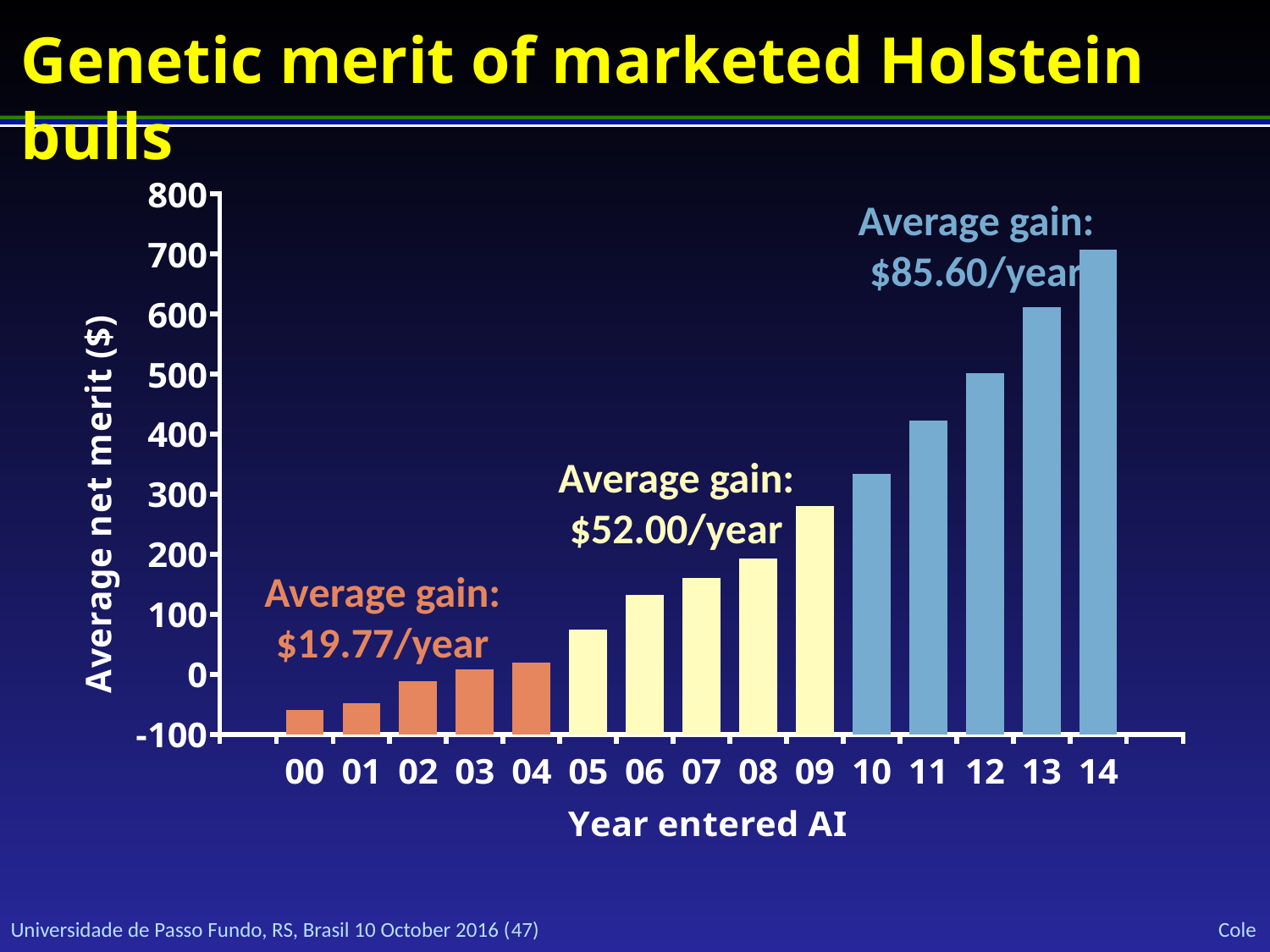
Do the values rise or fall as the year entered AI increases from 00 to 14? rise How many years (bars) are plotted on the x axis? 15 What average gain per year is annotated for the blue bars (years 10 to 14)? $85.60/year Which has the larger average net merit, year 09 or year 10? 10 Which year entered AI has the highest average net merit? 14 Is the value for year 00 greater or less than 0? less Is the value for year 10 greater or less than 300? greater What kind of chart is shown on the slide? bar chart Is the value for year 14 greater or less than 600? greater What is the title of the x axis? Year entered AI Which year entered AI has the lowest average net merit? 00